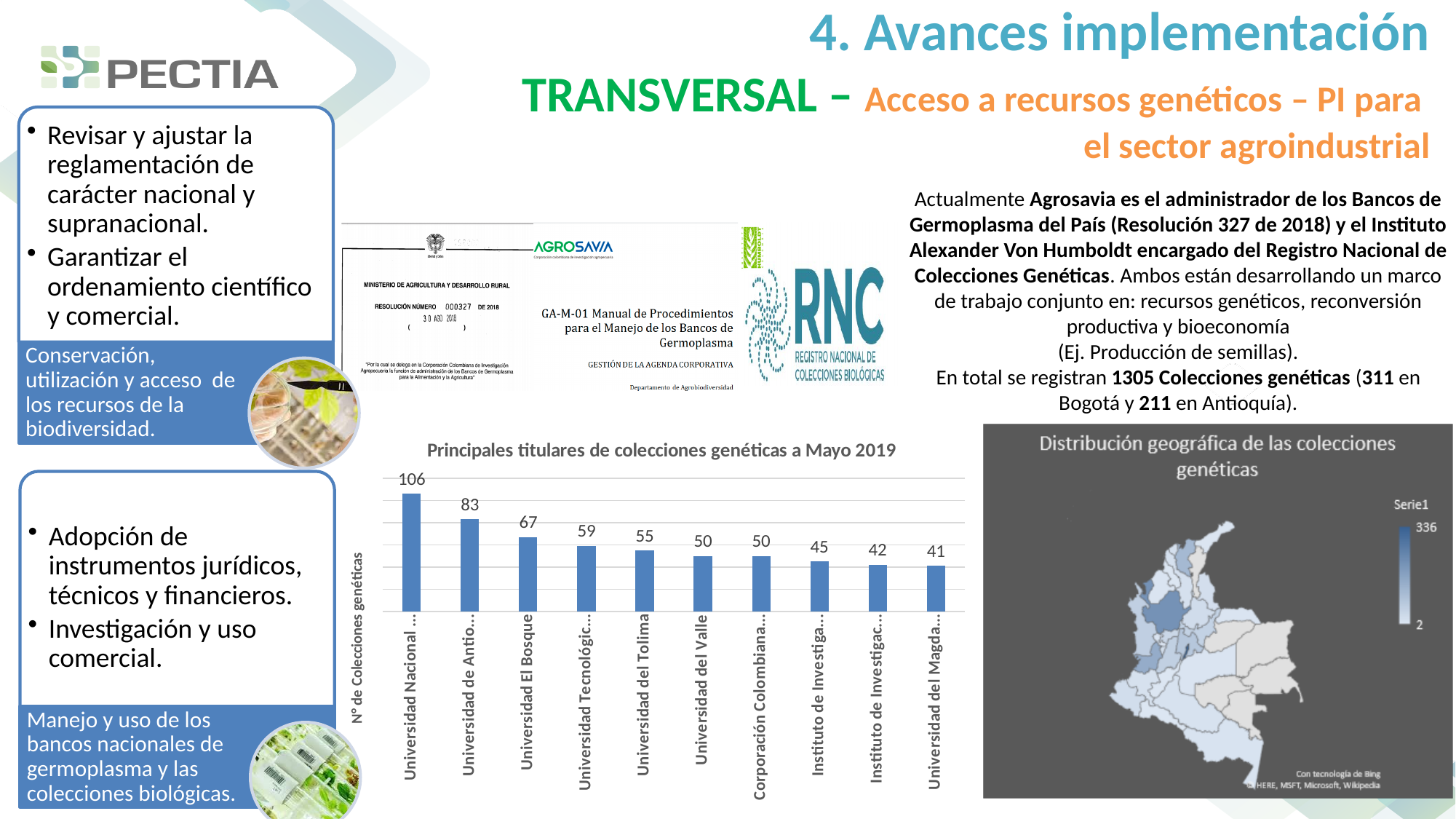
How many bars are shown in the chart 'Principales titulares de colecciones genéticas a Mayo 2019'? 10 In the chart 'Principales titulares de colecciones genéticas a Mayo 2019', which is larger: the value for Universidad El Bosque or the value for Universidad del Valle? Universidad El Bosque In the chart 'Principales titulares de colecciones genéticas a Mayo 2019', what is the value of the first (leftmost) bar? 106 In the chart 'Principales titulares de colecciones genéticas a Mayo 2019', which category has the highest value? Universidad Nacional In the chart 'Principales titulares de colecciones genéticas a Mayo 2019', what is the value for Universidad del Tolima? 55 In the chart 'Principales titulares de colecciones genéticas a Mayo 2019', what is the value of the lowest bar? 41 In the chart 'Principales titulares de colecciones genéticas a Mayo 2019', what is the value for Universidad del Valle? 50 What kind of chart is 'Principales titulares de colecciones genéticas a Mayo 2019'? Bar chart In the chart 'Principales titulares de colecciones genéticas a Mayo 2019', what is the value for Universidad El Bosque? 67 In the chart 'Principales titulares de colecciones genéticas a Mayo 2019', what is the difference between the values for Universidad El Bosque and Universidad del Tolima? 12 In the chart 'Principales titulares de colecciones genéticas a Mayo 2019', what is the difference between the highest bar (106) and the second bar (83)? 23 In the map chart 'Distribución geográfica de las colecciones genéticas', what are the maximum and minimum values shown on the colour scale legend? 336 and 2